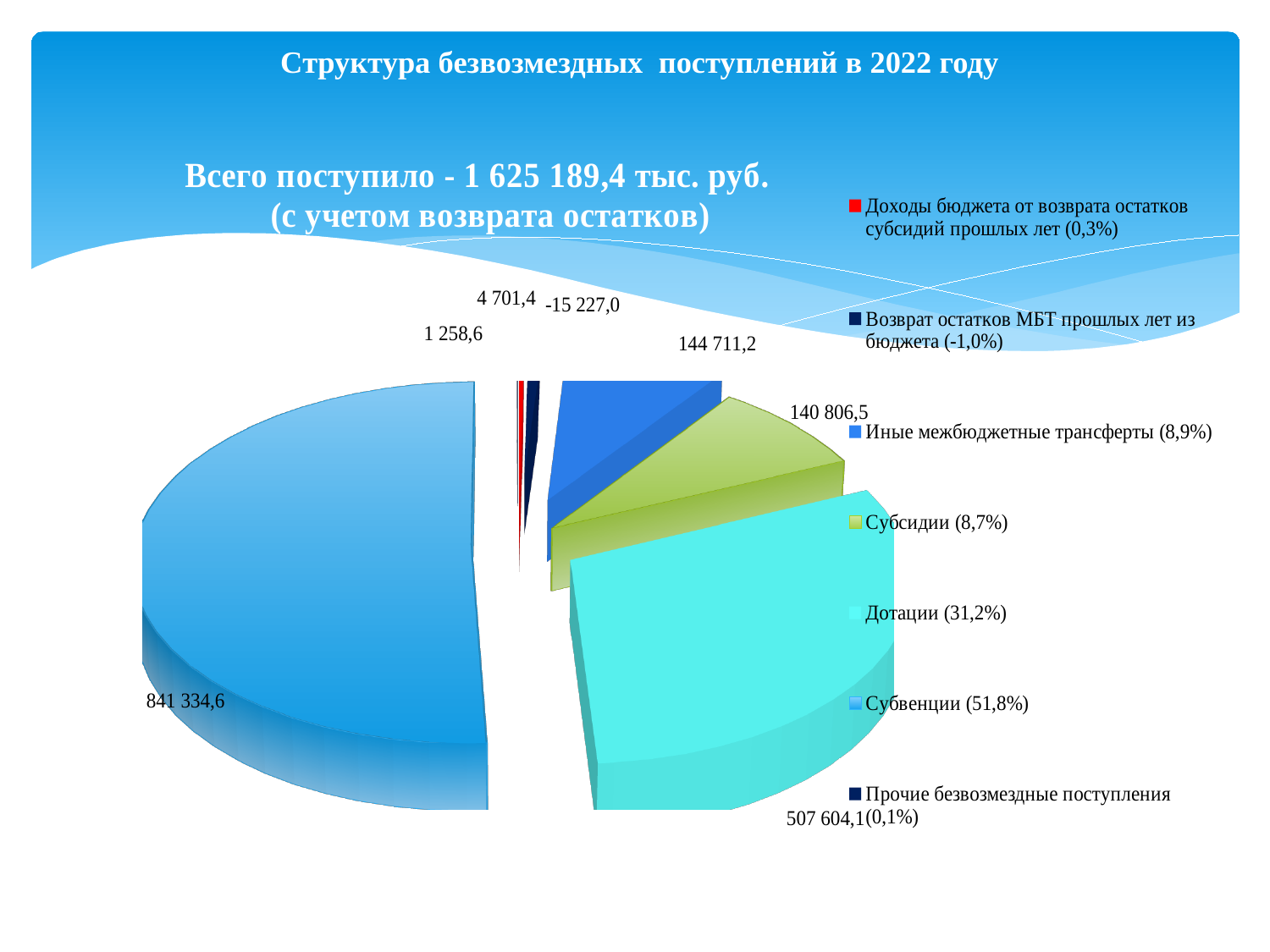
What kind of chart is shown on the slide? pie chart Which is larger, the value for Иные межбюджетные трансферты or the value for Субсидии? Иные межбюджетные трансферты What is the value shown for Дотации? 507 604,1 What share of the pie does Дотации account for? 31,2% Which category has the largest share of the pie? Субвенции What is the value shown for Иные межбюджетные трансферты? 144 711,2 What total amount of receipts is stated on the slide? 1 625 189,4 тыс. руб. What is the difference between the values for Субвенции and Дотации? 333 730,5 What is the title of the chart on the slide? Всего поступило - 1 625 189,4 тыс. руб. (с учетом возврата остатков) What share of the pie does Иные межбюджетные трансферты account for? 8,9% How many categories does the legend of the pie chart list? 7 What is the value shown for Субвенции? 841 334,6